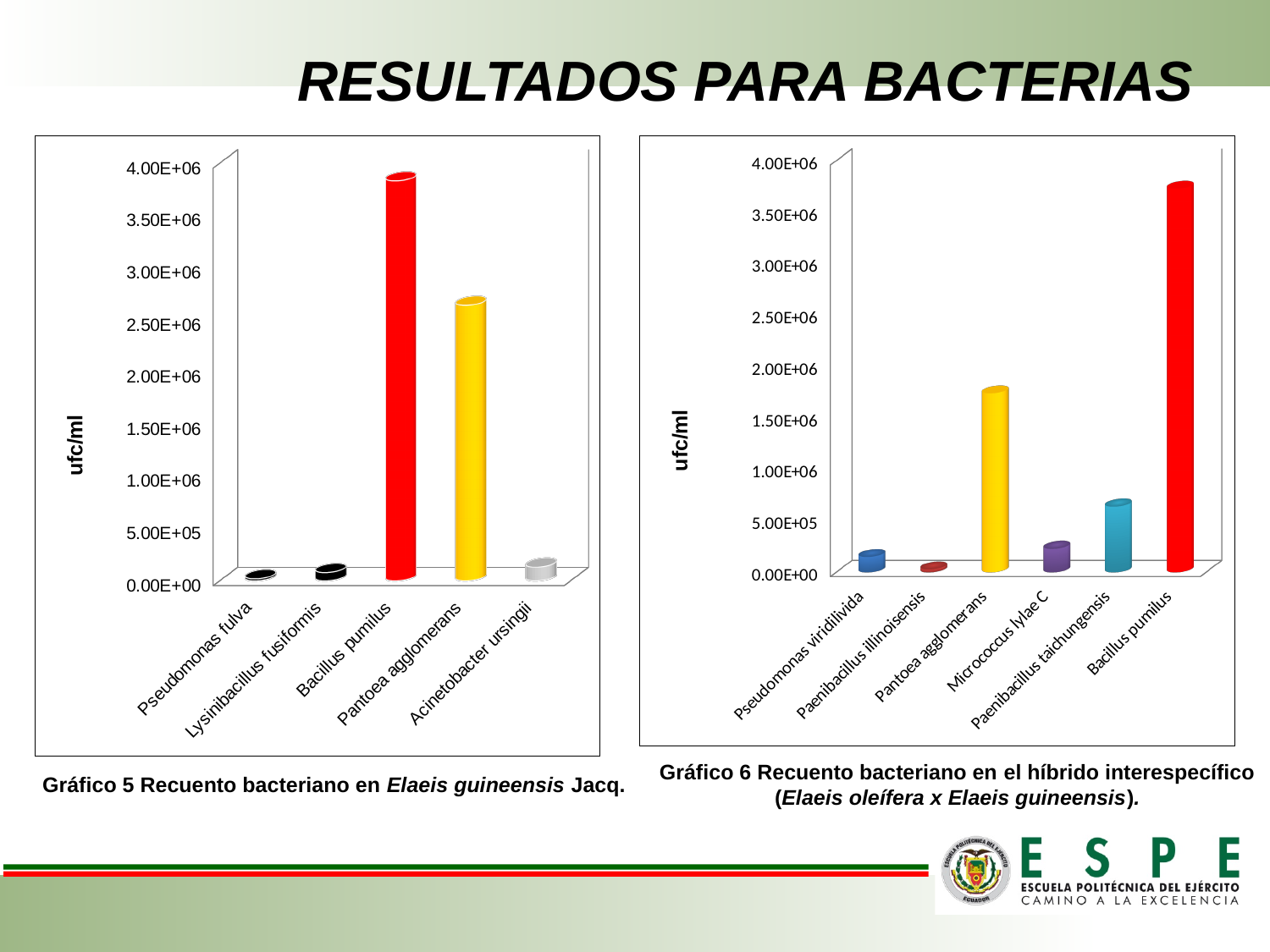
In Gráfico 6 (right chart), which bacterium has the lowest count? Paenibacillus illinoisensis In Gráfico 5 (left chart), is the value for Pantoea agglomerans greater or less than 2.00E+06? greater In Gráfico 6 (right chart), is the value for Paenibacillus taichungensis greater or less than 5.00E+05? greater In Gráfico 5 (left chart), which is larger, the value for Bacillus pumilus or the value for Pantoea agglomerans? Bacillus pumilus In Gráfico 5 (left chart), is the value for Bacillus pumilus greater or less than 3.50E+06? greater How many bacteria categories are shown in Gráfico 6 (right chart)? 6 In Gráfico 6 (right chart), which is larger, the value for Pantoea agglomerans or the value for Paenibacillus taichungensis? Pantoea agglomerans What kind of chart is Gráfico 5 (left chart)? Bar chart In Gráfico 5 (left chart), which bacterium has the highest count? Bacillus pumilus In Gráfico 6 (right chart), which bacterium has the highest count? Bacillus pumilus